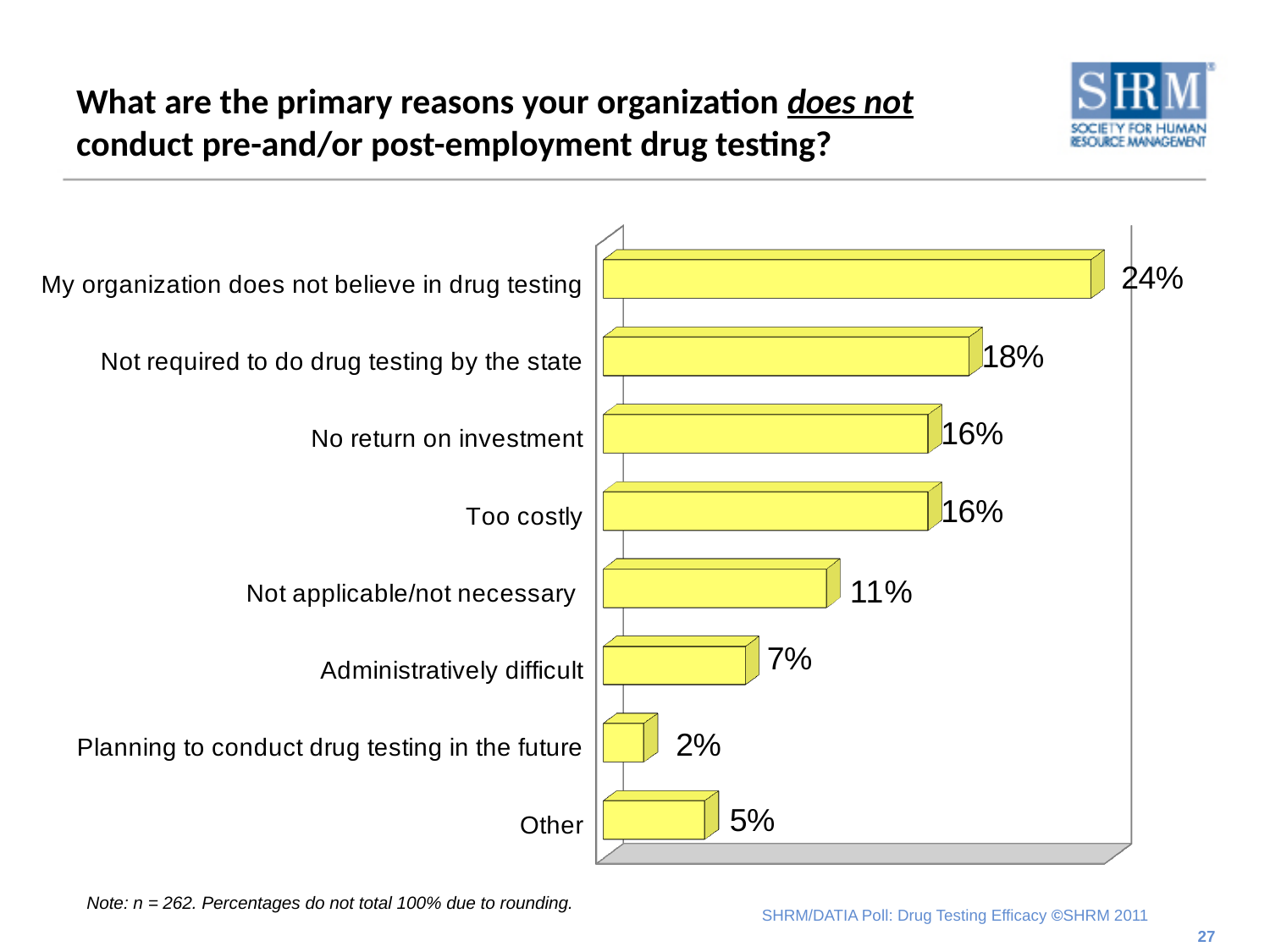
How many reasons (categories) are shown in the chart? 8 What kind of chart is shown on the slide? Bar chart What is the difference between 'My organization does not believe in drug testing' and 'Not required to do drug testing by the state'? 6% What is the difference between 'Not applicable/not necessary' and 'Other'? 6% What is the value for 'Planning to conduct drug testing in the future'? 2% What is the sample size (n) given in the note below the chart? 262 What percentage of respondents said their organization does not believe in drug testing? 24% What is the value for 'Not required to do drug testing by the state'? 18% What percentage is shown for 'Administratively difficult'? 7% Which is larger: 'Too costly' or 'Not applicable/not necessary'? Too costly Which reason has the highest percentage? My organization does not believe in drug testing Which reason has the lowest percentage? Planning to conduct drug testing in the future